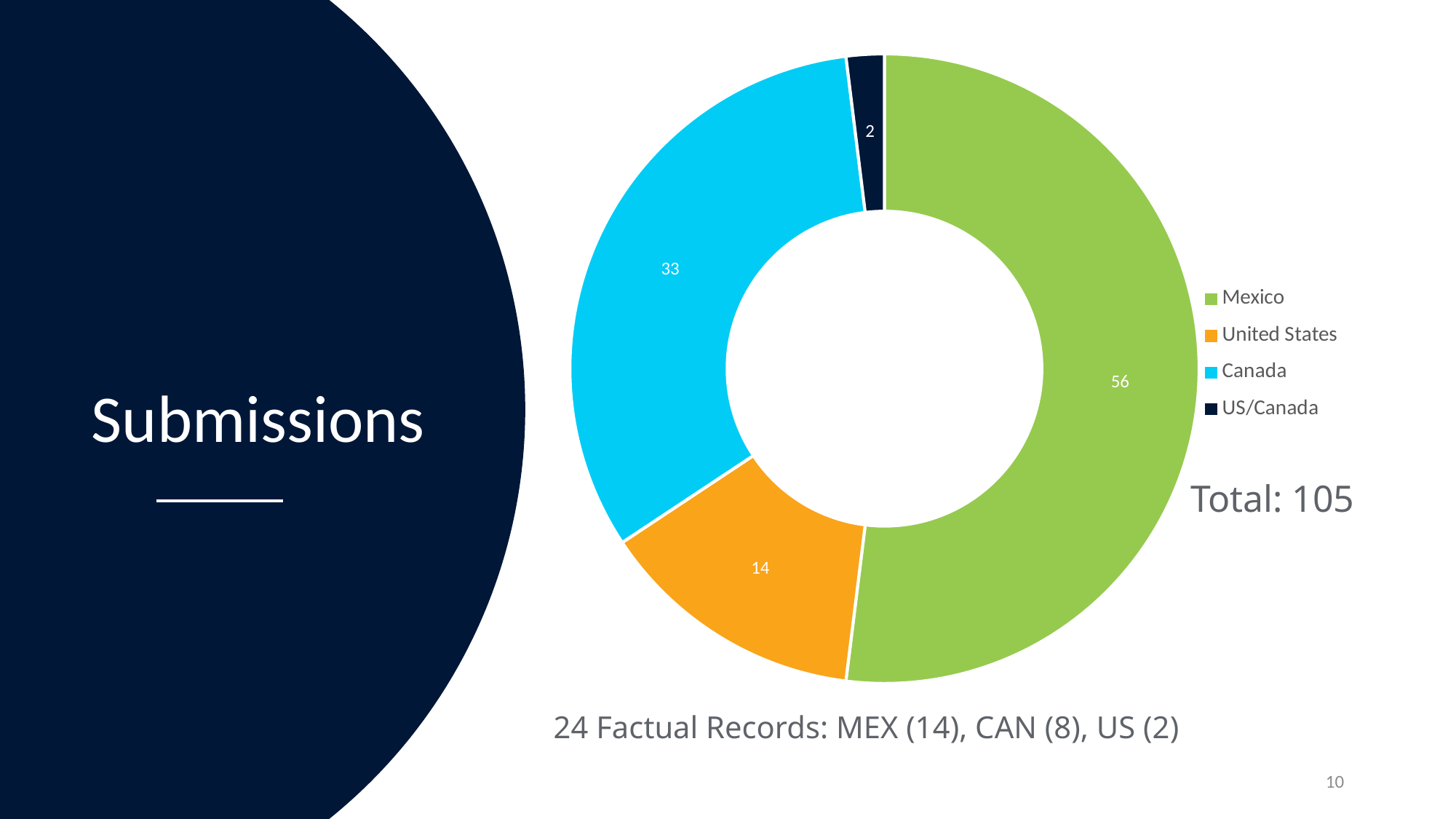
Which category has the smallest slice in the Submissions chart? US/Canada How many categories are shown in the Submissions chart? 4 What is the difference between the values for Mexico and Canada? 23 What kind of chart is shown on the slide? Doughnut (pie) chart What colour is the Canada slice in the chart? Light blue What is the value for US/Canada in the Submissions chart? 2 What total is stated next to the chart? Total: 105 Which is larger, the value for Canada or the value for United States? Canada What is the value for Canada in the Submissions chart? 33 Which category has the largest slice in the Submissions chart? Mexico What is the value for Mexico in the Submissions chart? 56 What is the value for United States in the Submissions chart? 14